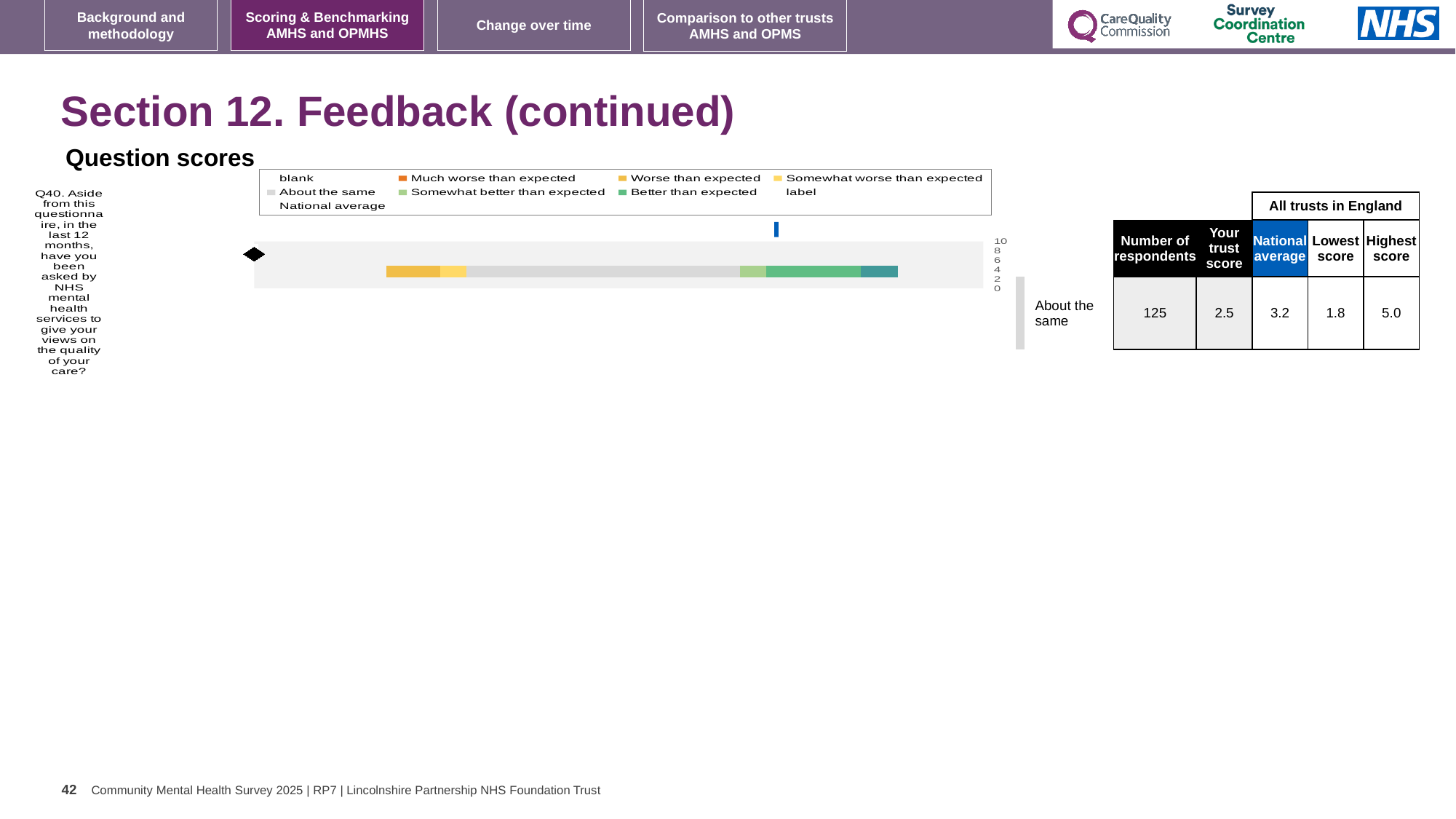
What is the national average score for Q40? 3.2 What kind of chart is shown under 'Question scores'? bar chart What is the highest score among all trusts in England for Q40? 5.0 How many respondents answered Q40? 125 What is the trust score for Q40? 2.5 What is the difference between the national average and the trust score for Q40? 0.7 Which benchmark category is the trust's Q40 score placed in? About the same What is the highest value shown on the axis of the Question scores chart? 10 Which is larger for Q40, the trust score or the national average? national average What is the lowest score among all trusts in England for Q40? 1.8 Which question is plotted in the Question scores chart? Q40 How many questions are plotted in the Question scores chart? 1